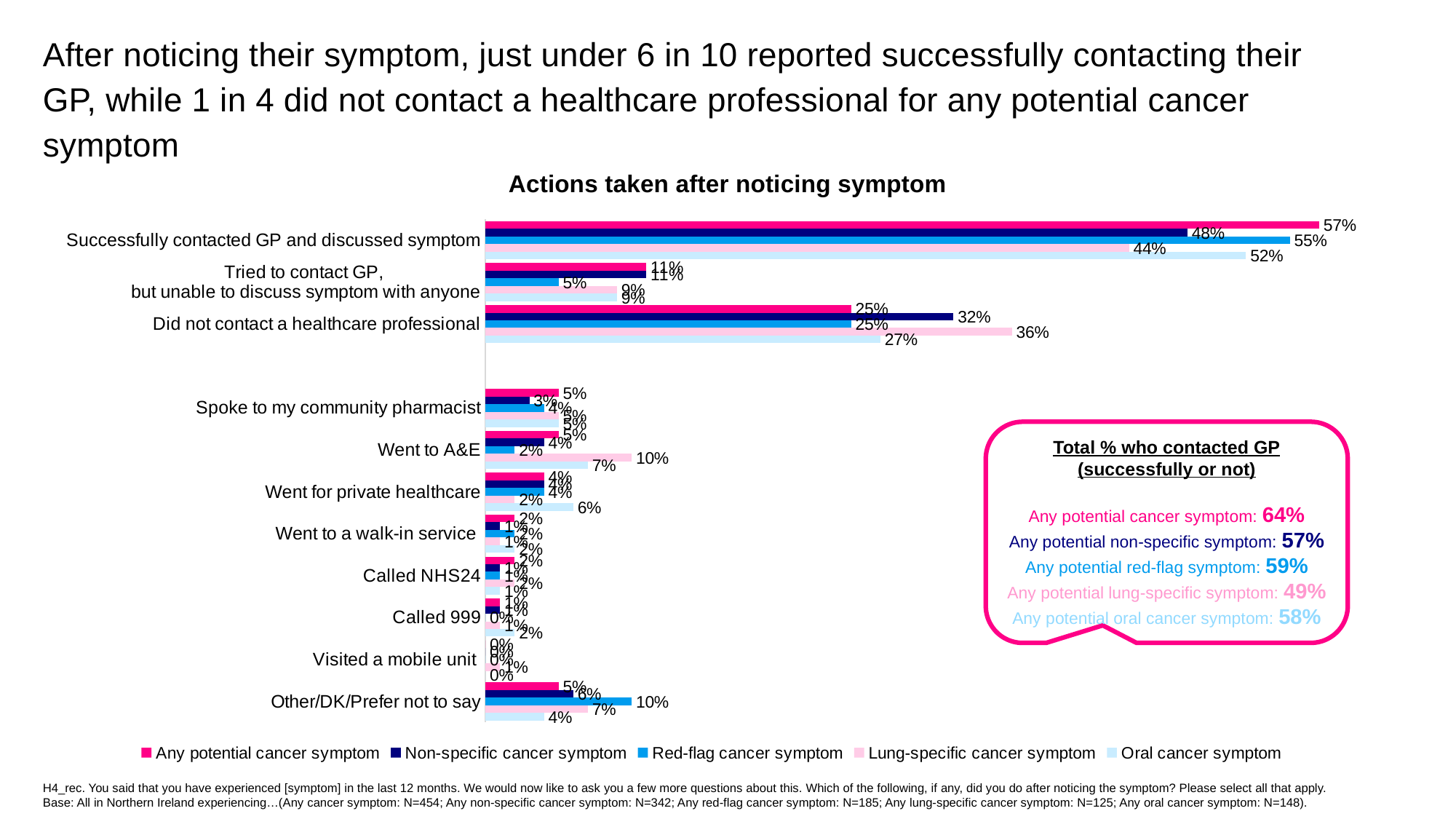
Which series has the highest value for 'Successfully contacted GP and discussed symptom'? Any potential cancer symptom For 'Did not contact a healthcare professional', which is larger: the 'Lung-specific cancer symptom' value or the 'Oral cancer symptom' value? Lung-specific cancer symptom What type of chart is shown on the slide? bar chart What is the value for 'Lung-specific cancer symptom' for 'Went to A&E'? 10% What is the value for 'Lung-specific cancer symptom' for 'Did not contact a healthcare professional'? 36% Which series has the lowest value for 'Successfully contacted GP and discussed symptom'? Lung-specific cancer symptom What is the value for 'Non-specific cancer symptom' for 'Did not contact a healthcare professional'? 32% What is the value for 'Red-flag cancer symptom' for 'Other/DK/Prefer not to say'? 10% What is the title of the chart? Actions taken after noticing symptom How many series does the legend list? 5 What is the difference between the 'Any potential cancer symptom' and 'Lung-specific cancer symptom' values for 'Successfully contacted GP and discussed symptom'? 13% What is the value for 'Any potential cancer symptom' for 'Successfully contacted GP and discussed symptom'? 57%